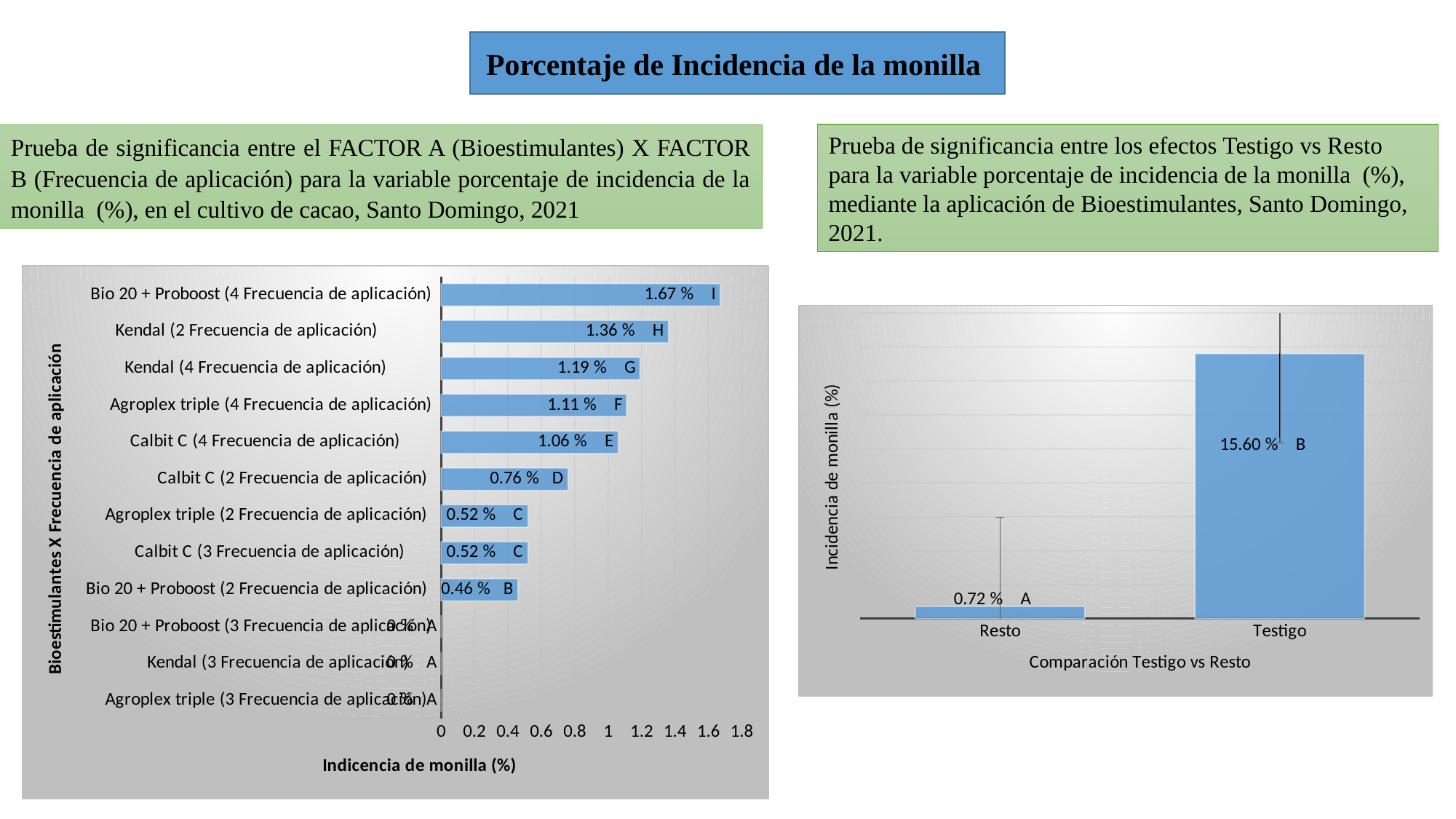
How many categories are plotted in the left chart? 12 In the left chart, which category has the highest incidence of monilla? Bio 20 + Proboost (4 Frecuencia de aplicación) In the left chart, which is larger: the value for Agroplex triple (4 Frecuencia de aplicación) or Calbit C (2 Frecuencia de aplicación)? Agroplex triple (4 Frecuencia de aplicación) In the right chart, what is the difference between the values for Testigo and Resto? 14.88 % In the right chart, what is the incidence value for Resto? 0.72 % In the left chart, what is the incidence value for Kendal (2 Frecuencia de aplicación)? 1.36 % In the left chart, what is the difference between the values for Bio 20 + Proboost (4 Frecuencia de aplicación) and Kendal (4 Frecuencia de aplicación)? 0.48 % What kind of chart is the left chart? Bar chart How many categories are plotted in the right chart? 2 In the left chart, what is the incidence value for Calbit C (4 Frecuencia de aplicación)? 1.06 % What is the x-axis title of the left chart? Indicencia de monilla (%) In the right chart, what is the incidence value for Testigo? 15.60 %